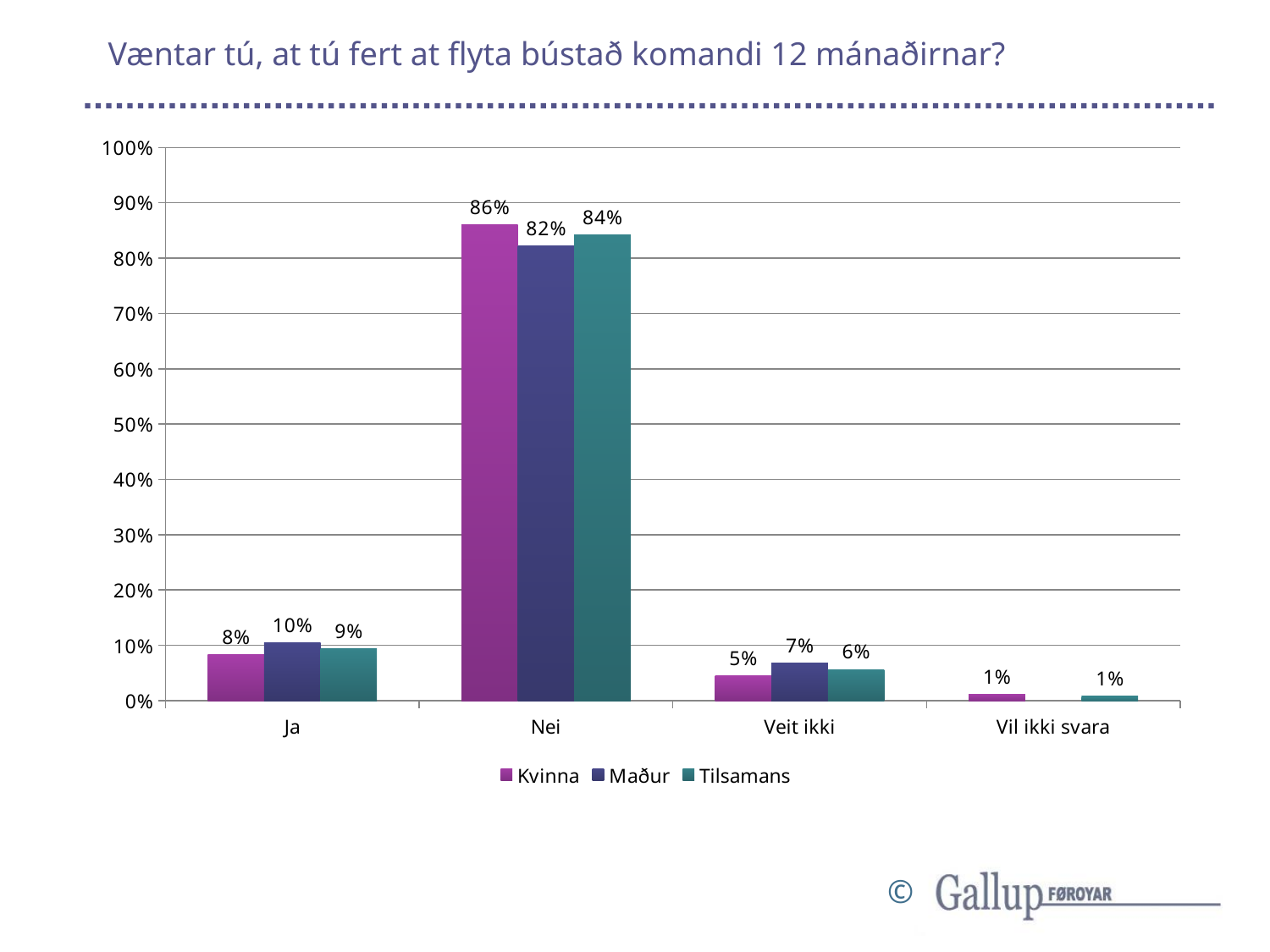
What is the value for Maður in the Ja category? 10% In the Ja category, which is larger: the value for Kvinna or the value for Maður? Maður Which category has the lowest value for Kvinna? Vil ikki svara What is the value for Tilsamans in the Veit ikki category? 6% Is the value for Maður in the Nei category greater or less than 80%? greater How many series does the legend list? 3 How many categories are shown on the x axis? 4 What is the difference between the Kvinna and Maður values in the Nei category? 4% Which category has the highest value for Tilsamans? Nei Which series is shown in purple/magenta in the legend? Kvinna What is the value for Kvinna in the Nei category? 86% What kind of chart is shown on the slide? Bar chart